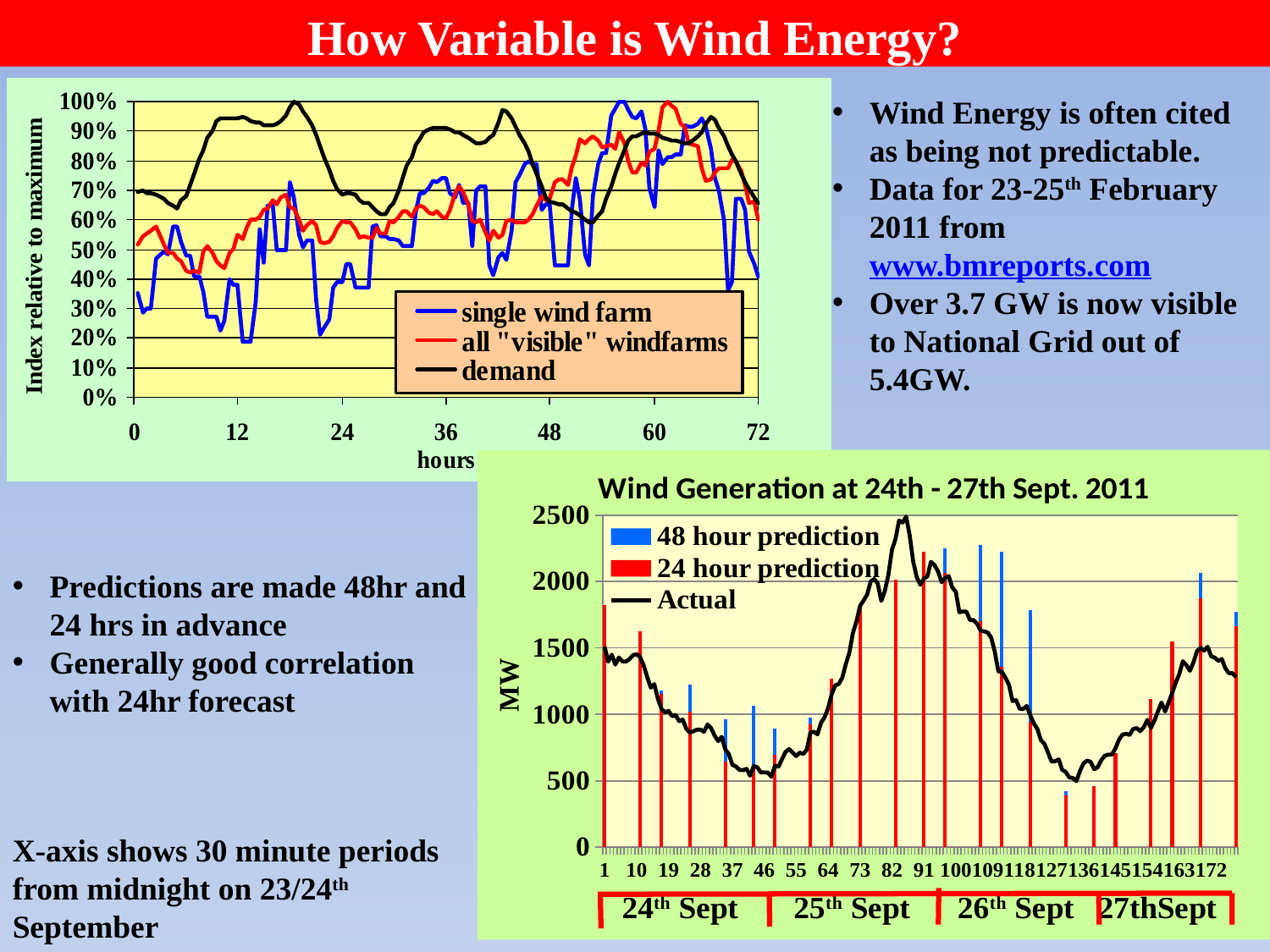
In the top-left chart, what is the label on the vertical axis? Index relative to maximum In the 'Wind Generation at 24th - 27th Sept. 2011' chart, is the Actual value at period 136 greater or less than 1000 MW? less What is the title of the bottom-right chart? Wind Generation at 24th - 27th Sept. 2011 In the top-left chart, is the demand value at hour 30 greater or less than 80%? less In the top-left chart, how many series does the legend list? 3 In the 'Wind Generation at 24th - 27th Sept. 2011' chart, does the Actual line rise or fall between period 46 and period 82? rise In the top-left chart, which series drops to the lowest value over the 72 hours? single wind farm In the 'Wind Generation at 24th - 27th Sept. 2011' chart, is the Actual value at period 82 greater or less than 2000 MW? greater What kind of chart is the top-left chart with the 'single wind farm', 'all "visible" windfarms' and 'demand' series? line chart In the 'Wind Generation at 24th - 27th Sept. 2011' chart, how many series does the legend list? 3